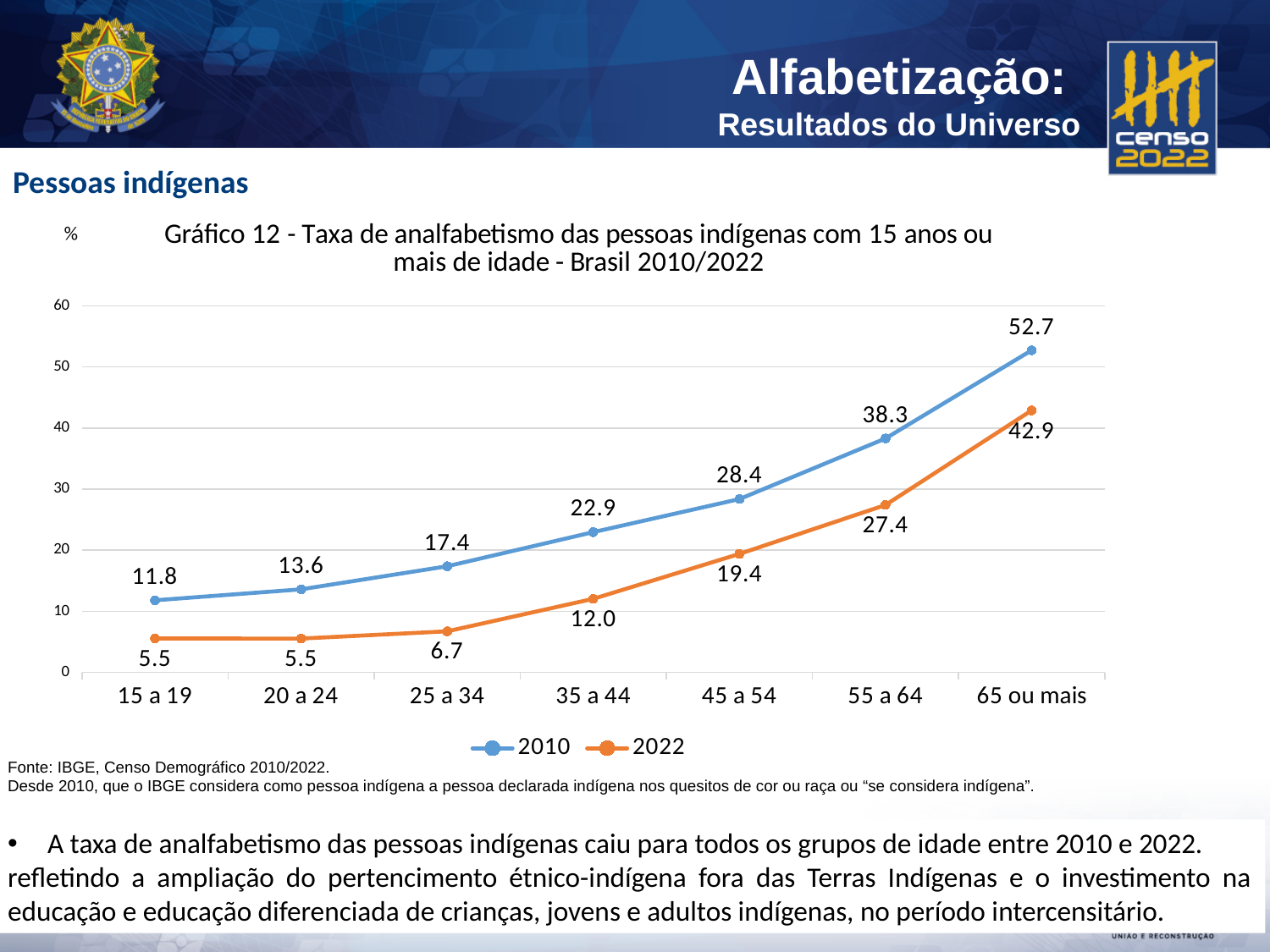
Which is larger: the 2010 value for 45 a 54 or the 2022 value for 65 ou mais? 2022 value for 65 ou mais What is the 2022 illiteracy rate for the 35 a 44 age group? 12.0 Which age group has the lowest 2010 illiteracy rate? 15 a 19 Which age group has the highest 2022 illiteracy rate? 65 ou mais What is the difference between the 2010 and 2022 values for the 55 a 64 age group? 10.9 Do the 2022 values rise or fall as age group increases along the x axis? Rise How many series does the legend list? 2 What is the 2022 value for the 15 a 19 age group? 5.5 What is the 2010 illiteracy rate for the 65 ou mais age group? 52.7 Which colour represents the 2022 series? Orange What kind of chart is shown? Line chart How many age groups are shown on the x axis? 7